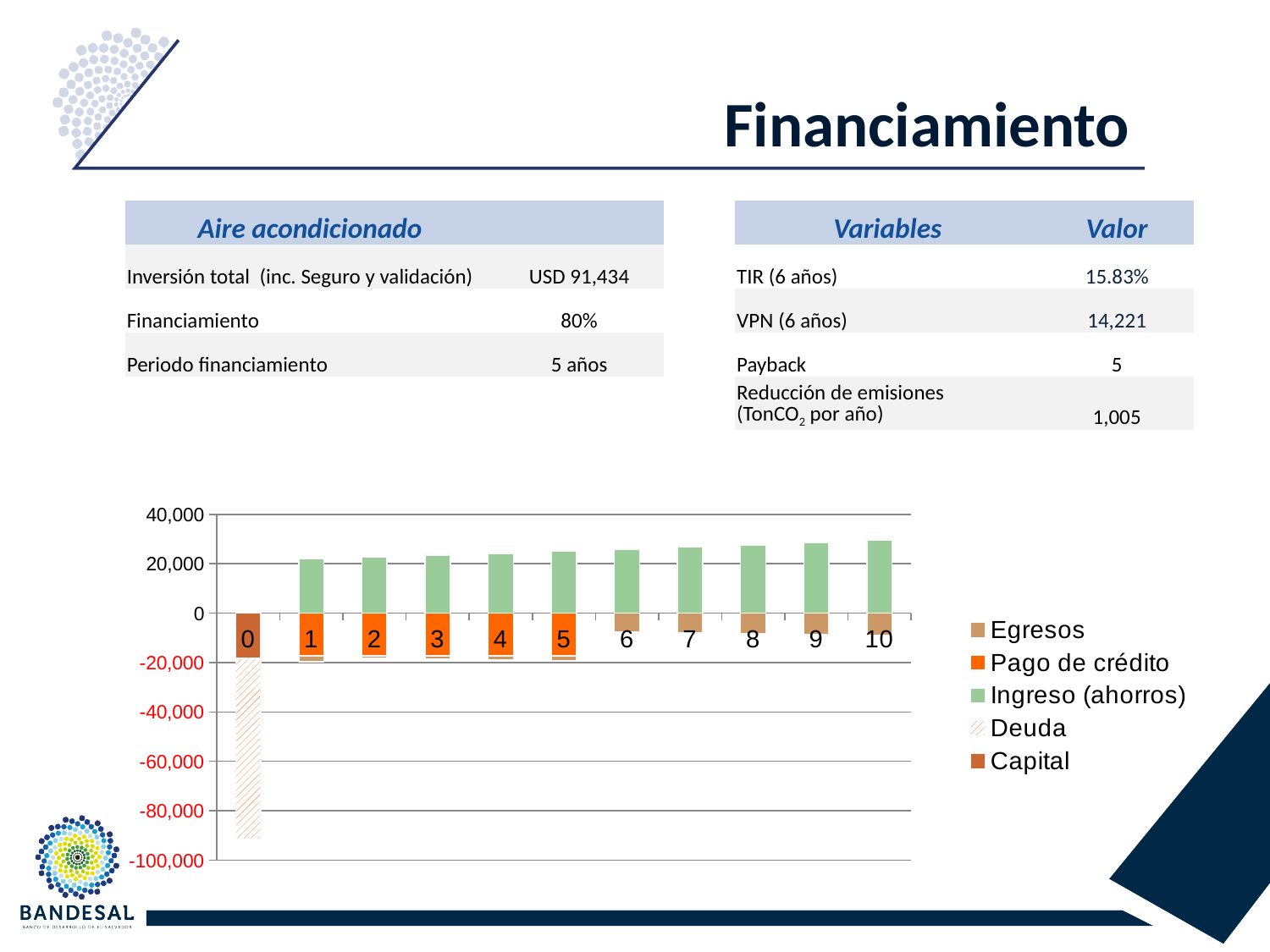
How many series does the chart legend list? 5 Among years 1 to 10, in which year is the Ingreso (ahorros) bar the lowest? 1 Is the Ingreso (ahorros) value for year 10 greater or less than 20,000? greater Which series are listed in the chart legend? Egresos, Pago de crédito, Ingreso (ahorros), Deuda, Capital What kind of chart is shown on the slide? Stacked bar chart How many categories (years) are shown on the x axis of the chart? 11 Which series in the chart is drawn with a hatched pattern? Deuda In which year is the Ingreso (ahorros) bar the highest? 10 Which is larger, the Ingreso (ahorros) value for year 10 or for year 1? Year 10 Is the Ingreso (ahorros) value for year 6 greater or less than 20,000? greater Does the Ingreso (ahorros) series rise or fall from year 1 to year 10? Rises Is the bottom of the stacked bar for year 0 greater or less than -80,000? less